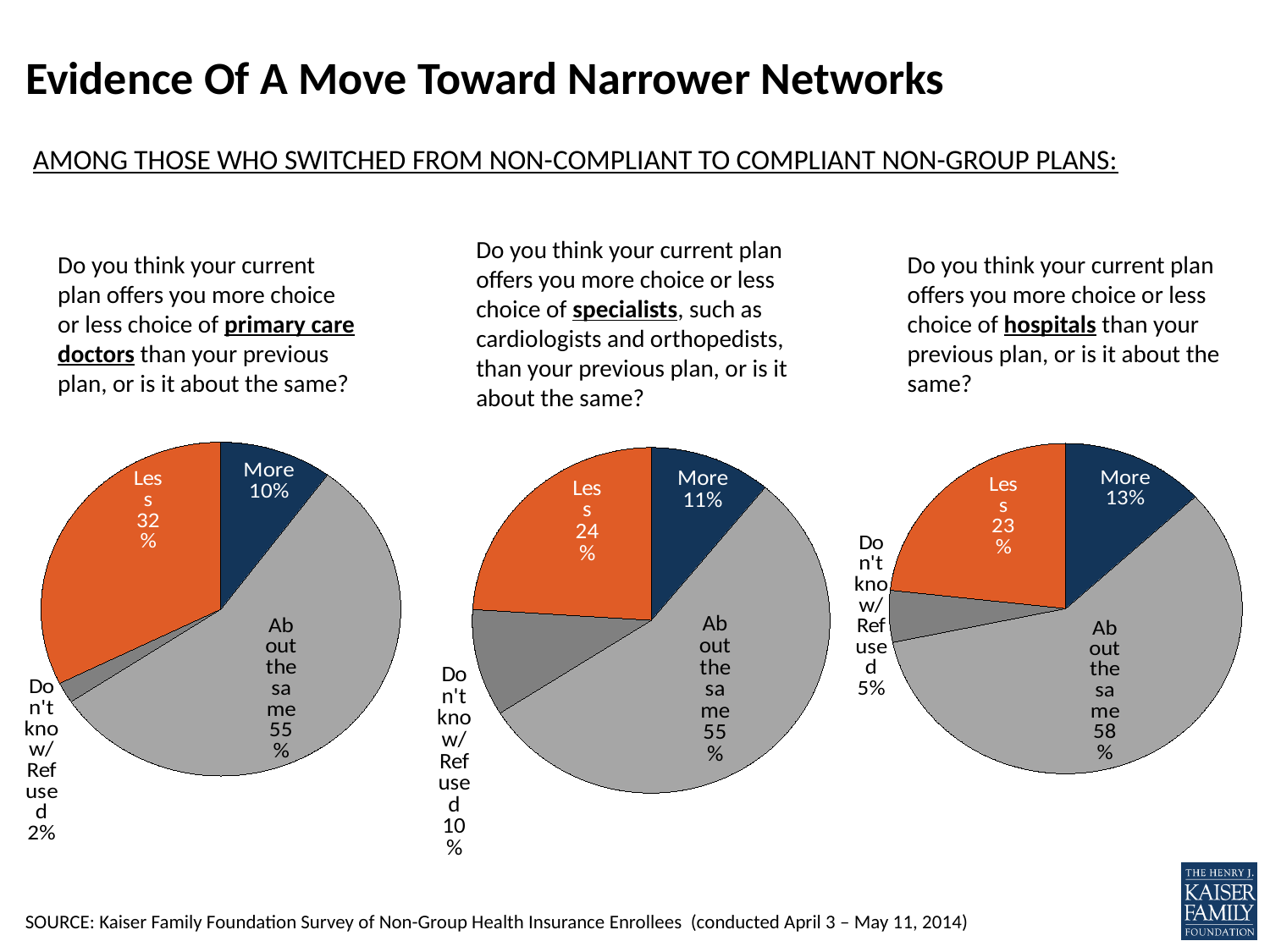
In the hospitals pie chart (right), which response has the smallest share? Don't know/Refused In the hospitals pie chart (right), what share of respondents said the choice is about the same? 58% Is the Less share larger in the primary care doctors pie chart (left) or in the hospitals pie chart (right)? Primary care doctors In the specialists pie chart (middle), what share of respondents said their current plan offers more choice? 11% In the primary care doctors pie chart (left), which response has the largest share? About the same How many slices does the hospitals pie chart (right) have? 4 In the specialists pie chart (middle), which is larger: the Less share or the Don't know/Refused share? Less In the primary care doctors pie chart (left), what colour is the Less slice? Orange In the primary care doctors pie chart (left), what share of respondents said their current plan offers less choice? 32% What type of chart is used to show the responses about choice of specialists (middle)? Pie chart In the primary care doctors pie chart (left), what is the difference between the Less share and the More share? 22 percentage points In the specialists pie chart (middle), what share of respondents answered Don't know/Refused? 10%